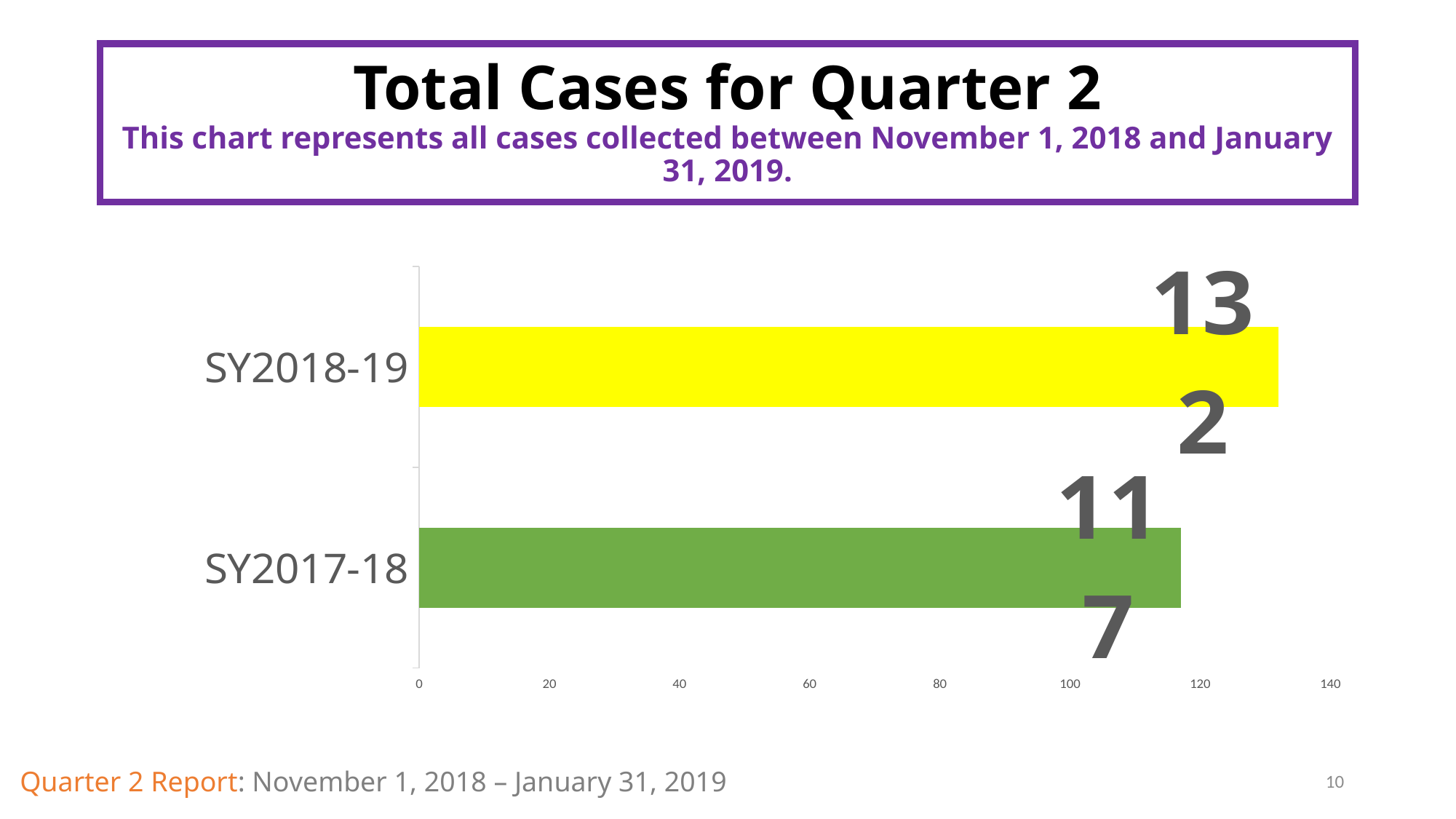
What is the value for SY2018-19? 132 Is the value for SY2018-19 greater or less than 140? less Which school year has the higher total cases? SY2018-19 What is the value for SY2017-18? 117 Which school year has the lower total cases? SY2017-18 What is the title of the chart? Total Cases for Quarter 2 Is the value for SY2018-19 larger or smaller than the value for SY2017-18? larger How many categories are shown in the chart? 2 What colour is the bar for SY2017-18? green Is the value for SY2017-18 greater or less than 100? greater What kind of chart is shown on the slide? bar chart What is the difference between the values for SY2018-19 and SY2017-18? 15